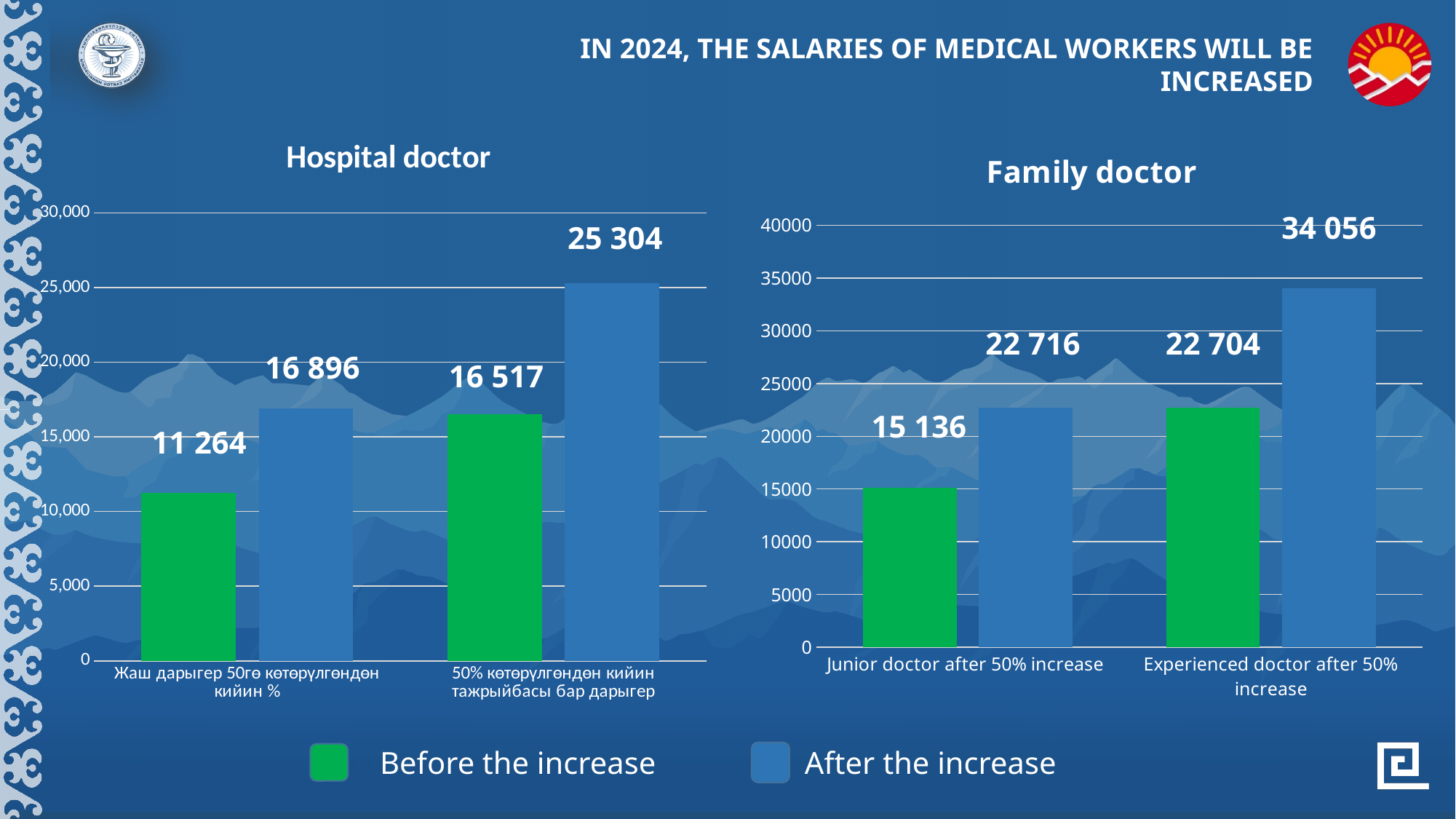
In the Hospital doctor chart, what is the 'After the increase' value for the second (right-hand) category? 25 304 What type of chart is the Family doctor chart? bar chart In the Family doctor chart, what is the value for 'After the increase' for Experienced doctor after 50% increase? 34 056 In the Family doctor chart, what is the value for 'Before the increase' for Junior doctor after 50% increase? 15 136 In the Hospital doctor chart, what is the difference between the 'After the increase' and 'Before the increase' values for the second (right-hand) category? 8 787 Which colour represents 'Before the increase' in the legend? green In the Hospital doctor chart, what is the 'Before the increase' value for the first (left-hand) category? 11 264 In the Family doctor chart, which bar has the highest value? After the increase, Experienced doctor after 50% increase In the Hospital doctor chart, which bar has the lowest value? Before the increase, first (left-hand) category In the Family doctor chart, what is the difference between the 'After the increase' and 'Before the increase' values for Junior doctor after 50% increase? 7 580 How many series does the legend list? 2